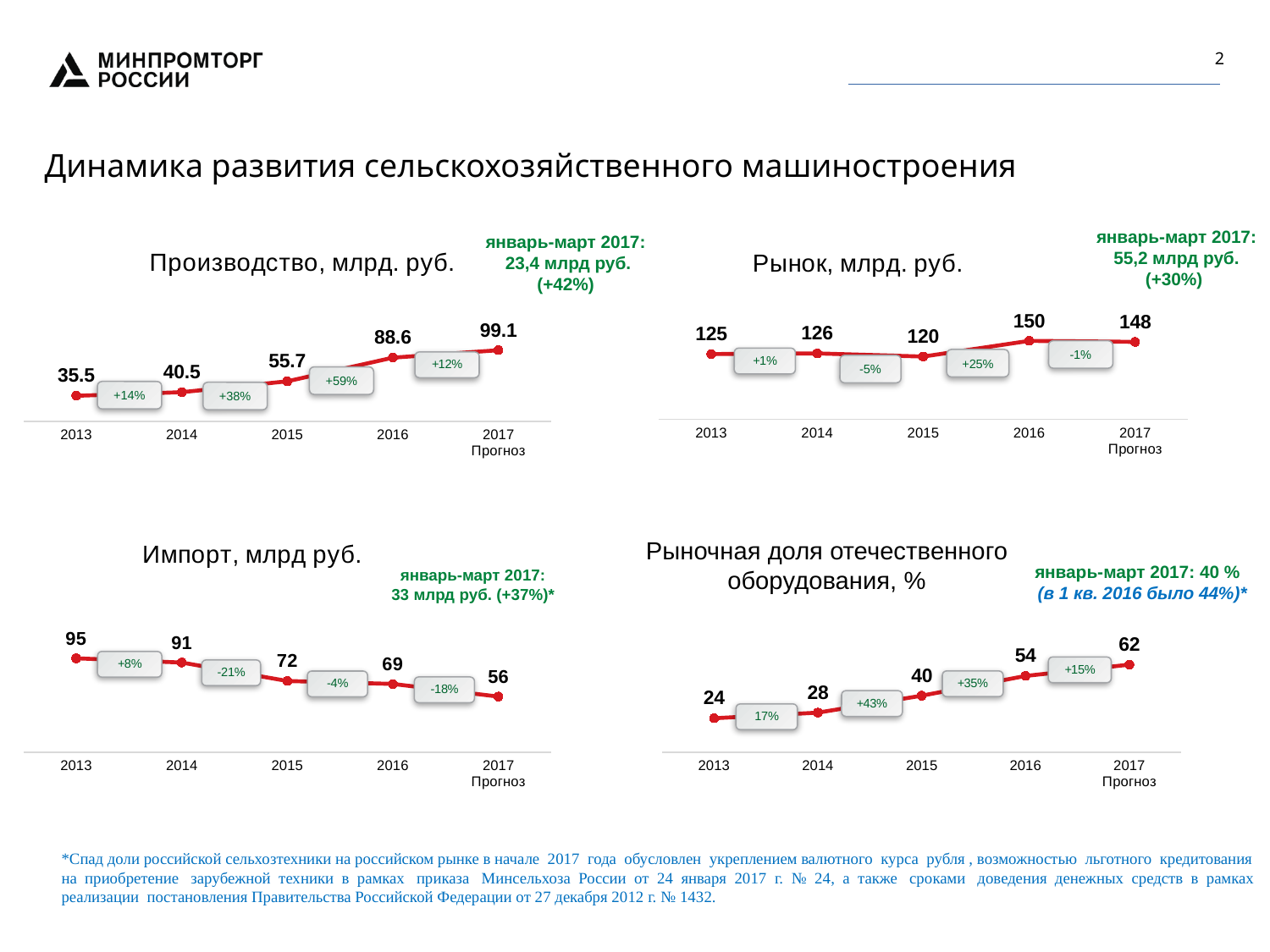
What type of chart is used for "Рыночная доля отечественного оборудования, %"? line chart In the chart titled "Рынок, млрд. руб.", what percentage change is shown between 2015 and 2016? +25% In the chart titled "Рынок, млрд. руб.", what is the value for 2015? 120 In the chart titled "Импорт, млрд руб.", what is the value for 2017 Прогноз? 56 In the chart titled "Импорт, млрд руб.", do the values generally rise or fall from 2013 to 2017 Прогноз? fall In the chart titled "Производство, млрд. руб.", what is the difference between the 2017 Прогноз value and the 2016 value? 10.5 In the chart titled "Рынок, млрд. руб.", which year has the highest value? 2016 In the chart titled "Производство, млрд. руб.", what is the value for 2016? 88.6 In the chart titled "Импорт, млрд руб.", what is the difference between the 2013 value and the 2015 value? 23 In the chart titled "Производство, млрд. руб.", which year has the lowest value? 2013 In the chart titled "Рыночная доля отечественного оборудования, %", which is larger: the value for 2015 or the value for 2016? 2016 In the chart titled "Рыночная доля отечественного оборудования, %", how many years are plotted on the x axis? 5